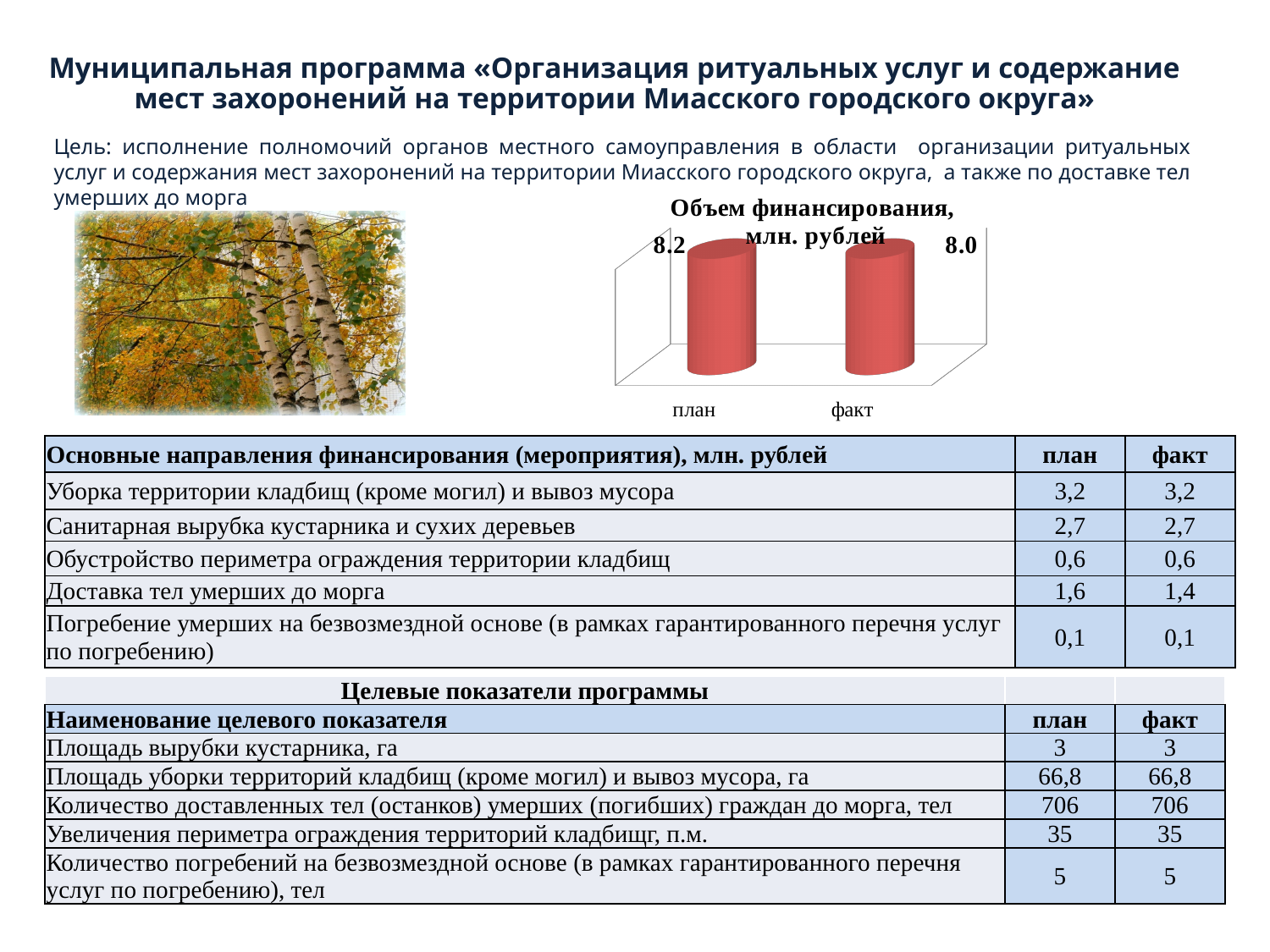
Is the value for план larger or smaller than the value for факт in the chart 'Объем финансирования, млн. рублей'? larger What is the value for план in the chart 'Объем финансирования, млн. рублей'? 8.2 What colour are the bars in the chart 'Объем финансирования, млн. рублей'? red Which category has the higher value in the chart 'Объем финансирования, млн. рублей'? план Which category has the lower value in the chart 'Объем финансирования, млн. рублей'? факт What is the value for факт in the chart 'Объем финансирования, млн. рублей'? 8.0 What kind of chart is 'Объем финансирования, млн. рублей'? bar chart How many categories are shown in the chart 'Объем финансирования, млн. рублей'? 2 What is the title of the chart on the slide? Объем финансирования, млн. рублей Do the values rise or fall from план to факт in the chart 'Объем финансирования, млн. рублей'? fall What is the difference between план and факт in the chart 'Объем финансирования, млн. рублей'? 0.2